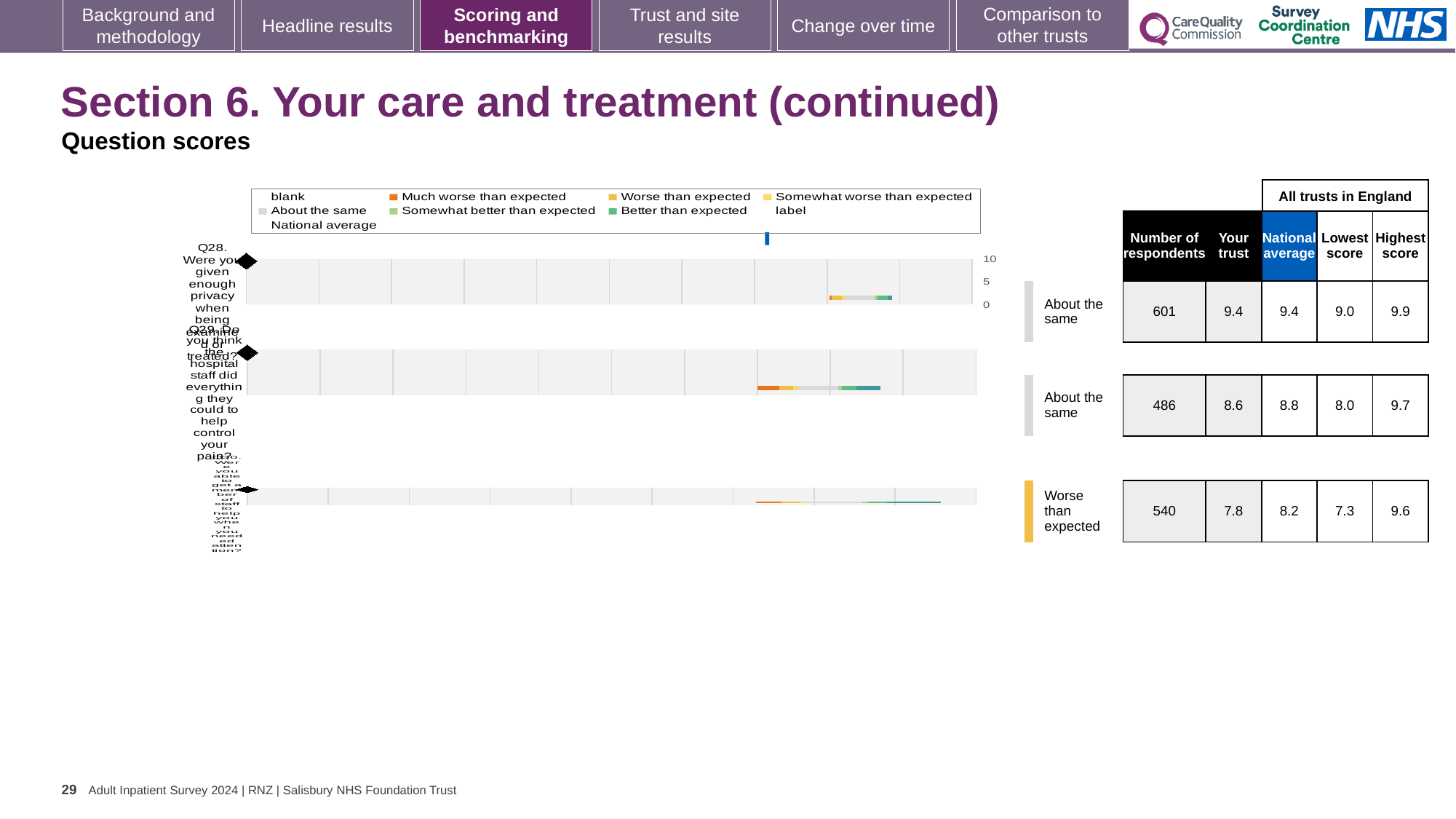
How many question rows are shown on the chart? 3 What is the national average score for Q29 (staff did everything to help control pain)? 8.8 What is the highest score across all trusts in England for Q28? 9.9 For Q29, which is larger: the 'Your trust' score or the national average? National average Which question has the highest 'Your trust' score? Q28 For the third question row (Q30), what is the difference between the national average and the 'Your trust' score? 0.4 What benchmark category is shown for the third question row (Q30)? Worse than expected What is the 'Your trust' score for Q28 (privacy when being examined or treated)? 9.4 How many respondents are listed for the third question row (Q30)? 540 Which question has the lowest 'Your trust' score? Q30 What kind of chart is used to show the question scores? Bar chart What is the lowest score across all trusts in England for the third question row (Q30)? 7.3